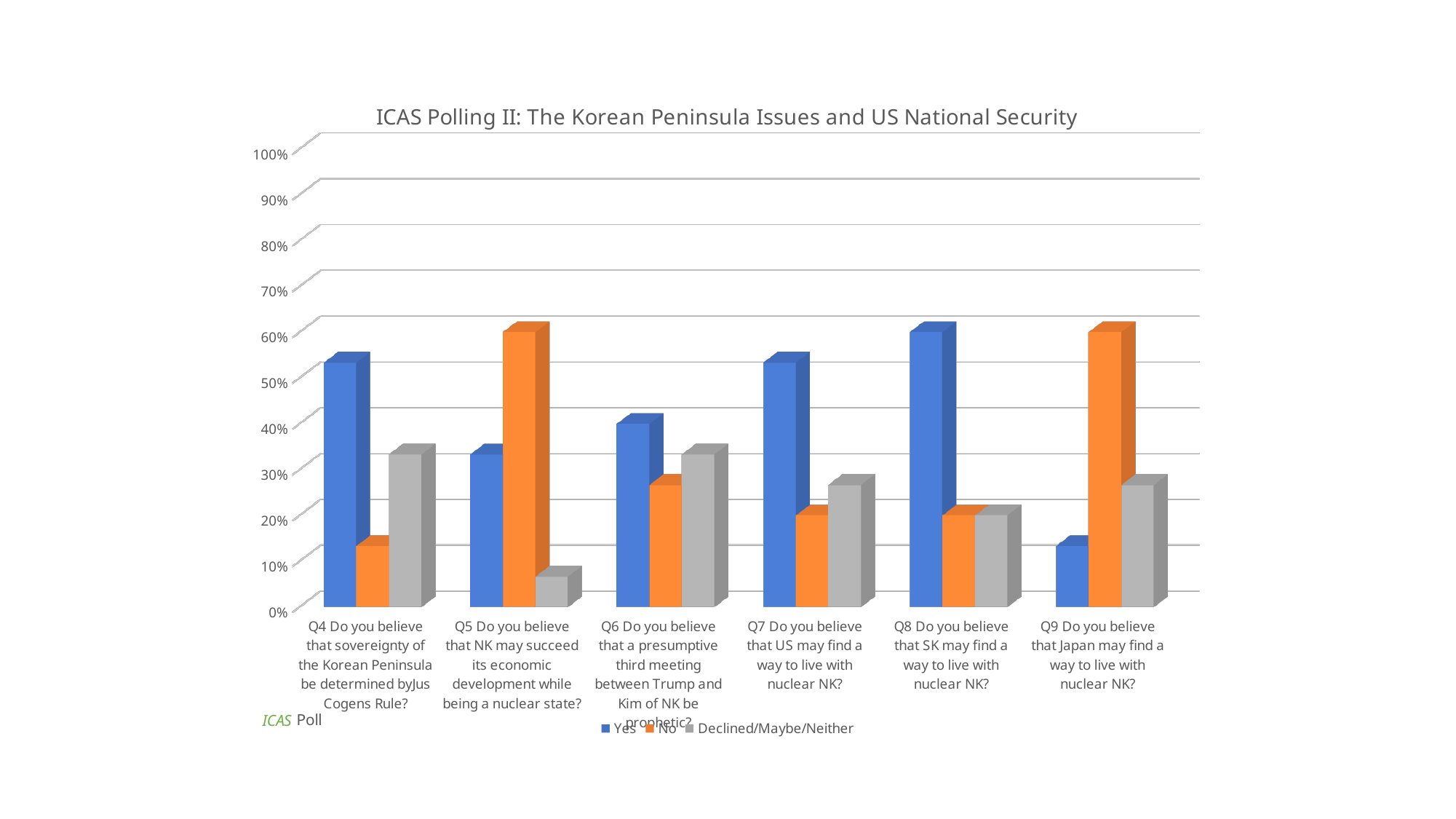
What is the title of the chart? ICAS Polling II: The Korean Peninsula Issues and US National Security What kind of chart is shown on the slide? bar chart For Q4, which response has the lowest value? No Which series is shown in orange in the legend? No For Q9, which is larger, the Yes value or the No value? No Is the Yes value for Q9 greater or less than 20%? less How many question categories are plotted along the x axis? 6 Is the No value for Q5 greater or less than 50%? greater How many series does the legend list? 3 For Q5, which response has the highest value? No Is the Declined/Maybe/Neither value for Q5 greater or less than 20%? less